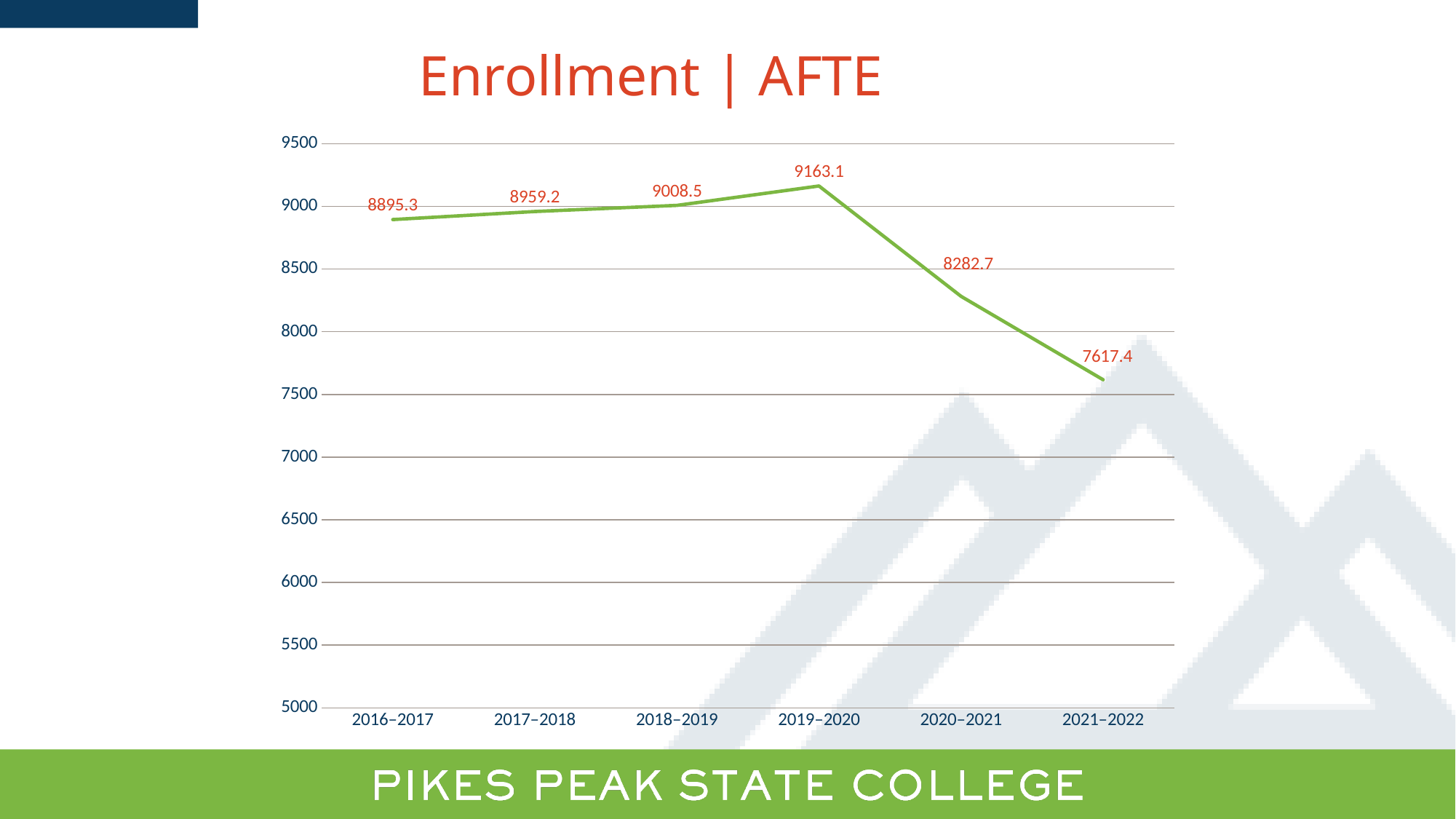
What kind of chart is shown on the slide? line chart Is the AFTE enrollment value for 2020–2021 greater or less than 8500? less What is the difference between the AFTE enrollment in 2019–2020 and 2021–2022? 1545.7 What is the AFTE enrollment value for 2021–2022? 7617.4 What is the AFTE enrollment value for 2019–2020? 9163.1 Which academic year has the lowest AFTE enrollment? 2021–2022 Which academic year has the highest AFTE enrollment? 2019–2020 What is the difference between the AFTE enrollment in 2020–2021 and 2021–2022? 665.3 How many academic years are plotted on the chart? 6 What is the AFTE enrollment value for 2016–2017? 8895.3 Does AFTE enrollment rise or fall from 2019–2020 to 2021–2022? fall Which is larger, the AFTE enrollment for 2017–2018 or for 2020–2021? 2017–2018